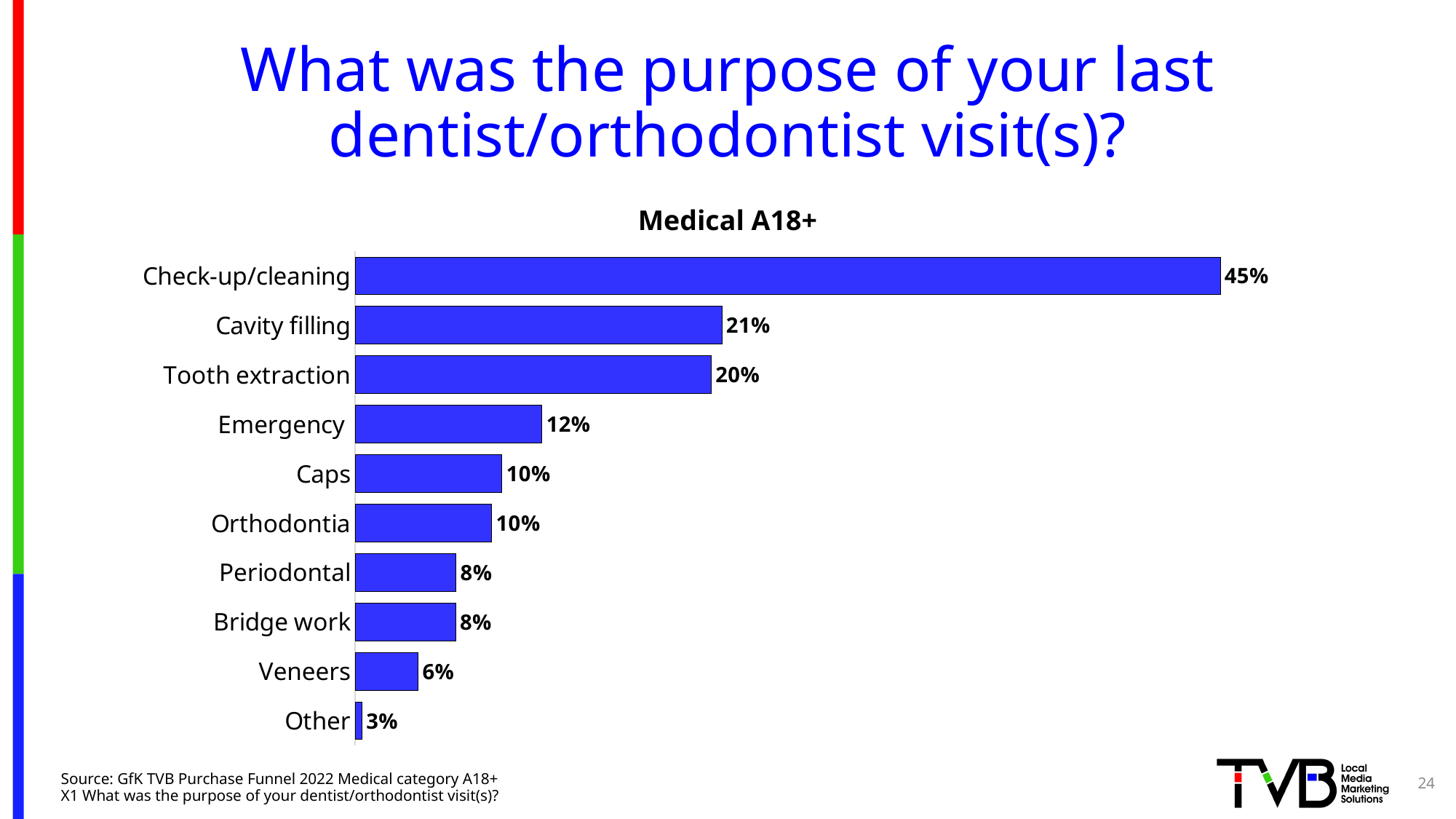
What is the value shown for Veneers? 6% What is the value shown for Emergency? 12% What is the difference between the values for Check-up/cleaning and Cavity filling? 24 percentage points Which category has the lowest value in the chart? Other How many categories are shown in the chart? 10 Which category has the highest value in the chart? Check-up/cleaning What is the title of the chart? Medical A18+ Which is larger, the value for Cavity filling or the value for Tooth extraction? Cavity filling Which is larger, the value for Caps or the value for Periodontal? Caps What is the difference between the values for Tooth extraction and Emergency? 8 percentage points What percentage of respondents said the purpose of their last dentist/orthodontist visit was Check-up/cleaning? 45% What kind of chart is shown on the slide? Bar chart